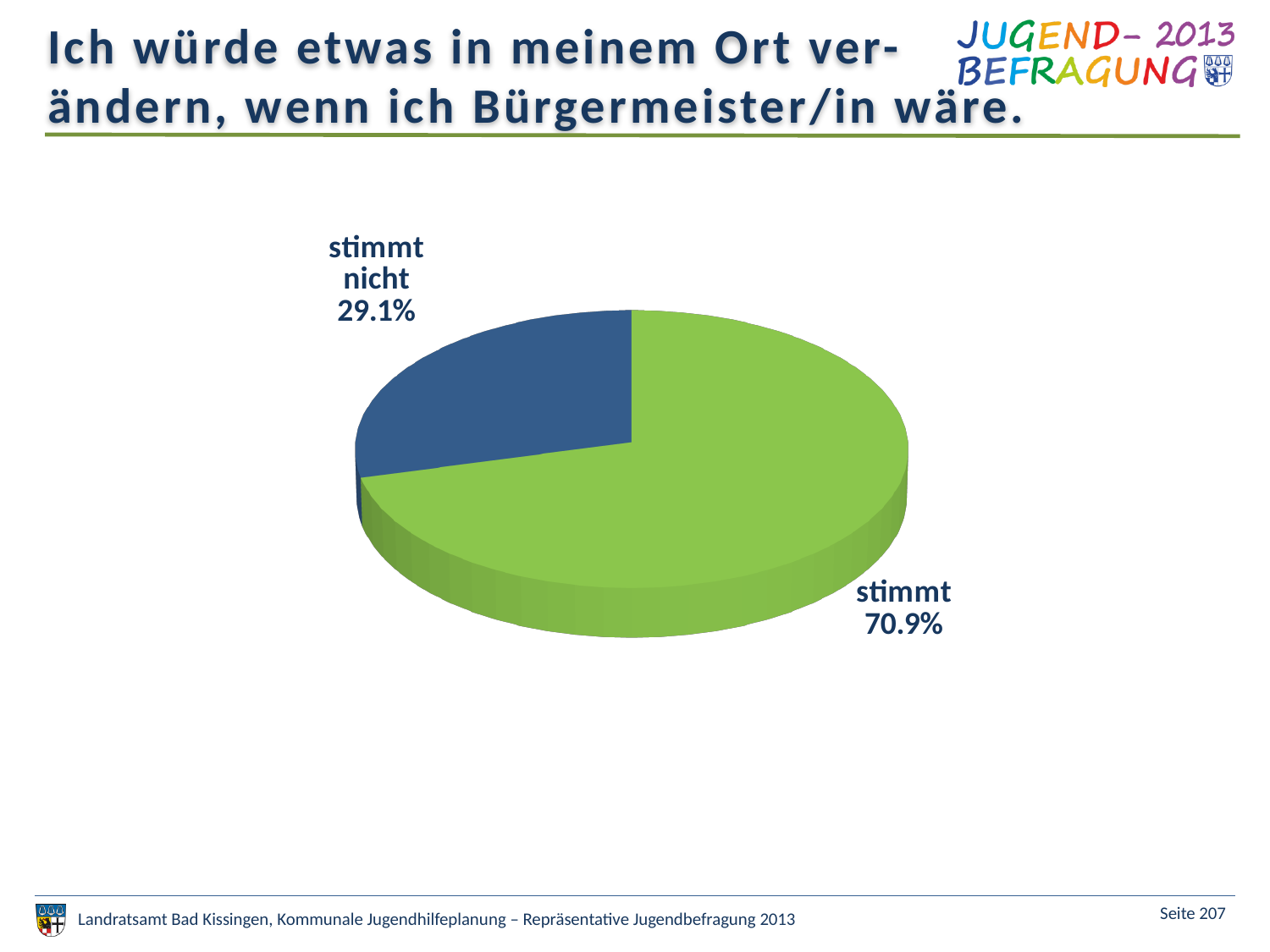
Which slice of the pie is the smallest? stimmt nicht Which slice of the pie is the largest? stimmt What colour is the "stimmt nicht" slice? blue What kind of chart is shown on the slide? pie chart What percentage of respondents answered "stimmt nicht"? 29.1% Which is larger, the share for "stimmt" or for "stimmt nicht"? stimmt What share of the pie does the "stimmt" slice represent? 70.9% What is the difference in percentage points between "stimmt" and "stimmt nicht"? 41.8 What percentage of respondents answered "stimmt"? 70.9% How many slices does the pie chart have? 2 What colour is the "stimmt" slice? green